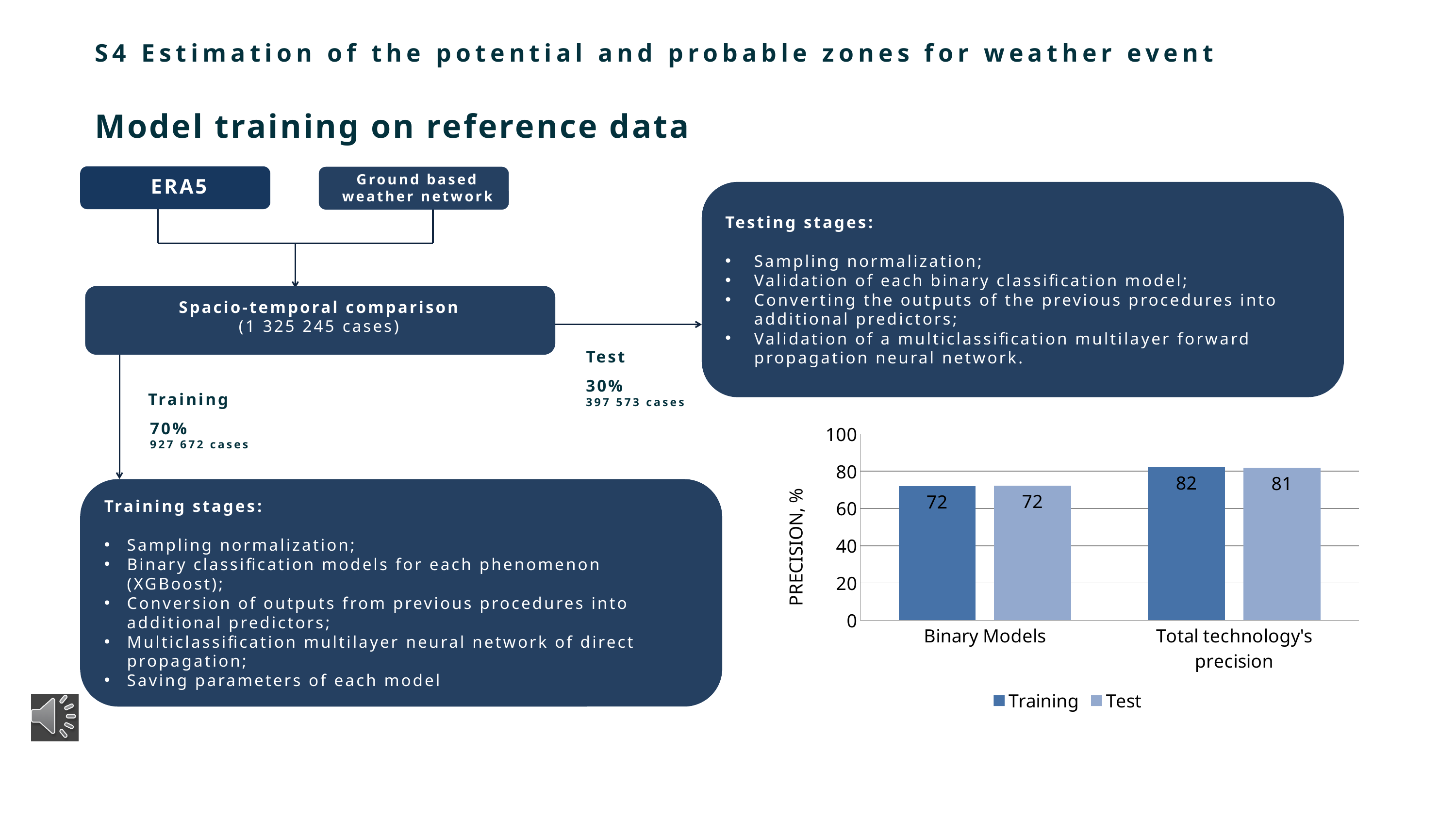
What kind of chart is shown on the slide? Bar chart What is the Training precision for Binary Models? 72 Which is larger: the Test precision for Total technology's precision or for Binary Models? Total technology's precision What is the label of the chart's y axis? PRECISION, % What is the difference between the Training precision for Total technology's precision and for Binary Models? 10 Which category has the highest Training precision? Total technology's precision How many categories are shown on the x axis of the chart? 2 What is the Test precision for Binary Models? 72 How many series does the chart legend list? 2 What is the Training precision for Total technology's precision? 82 What is the Test precision for Total technology's precision? 81 Which category has the lowest Test precision? Binary Models